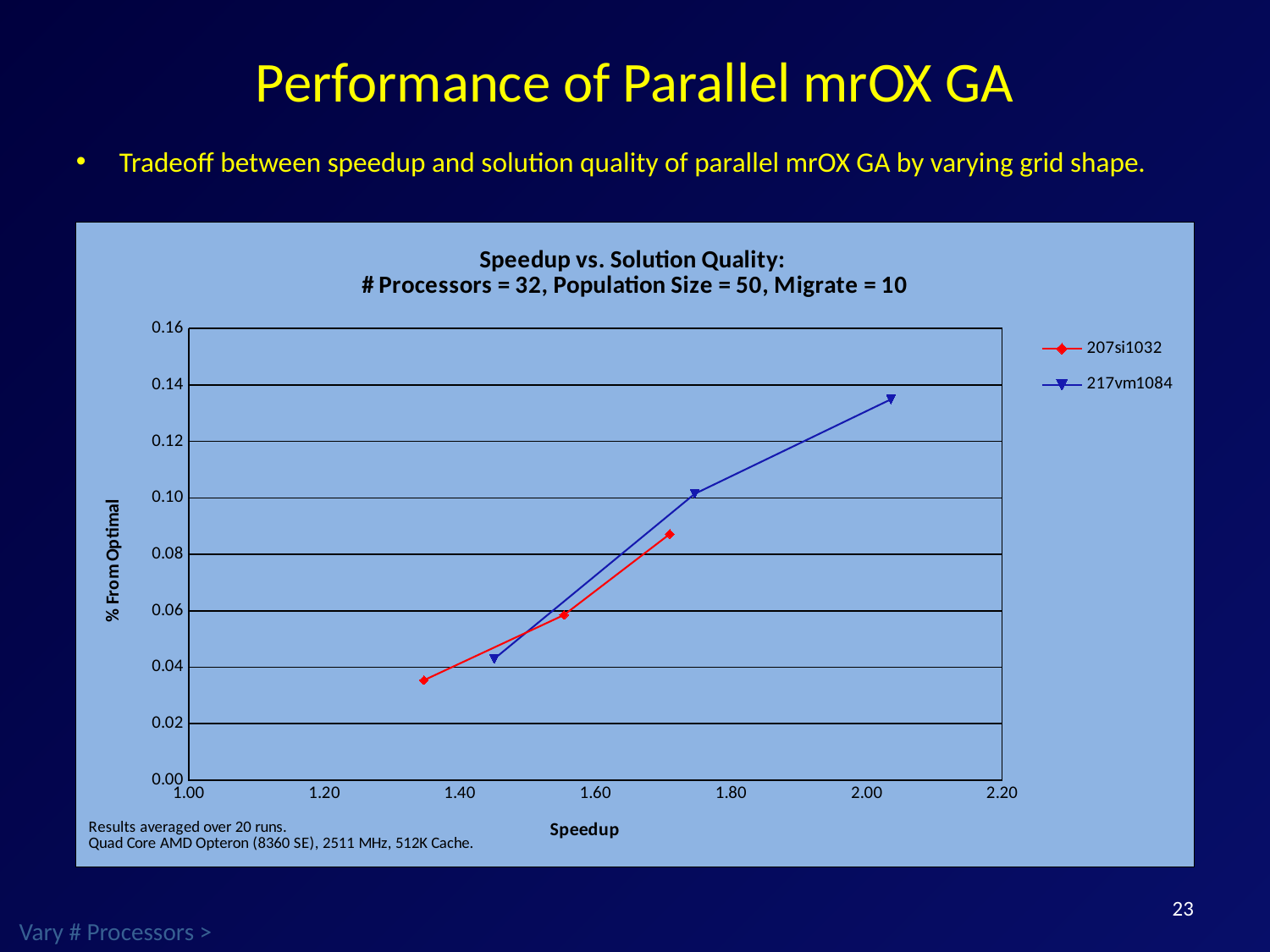
Which series reaches the higher maximum Speedup, 207si1032 or 217vm1084? 217vm1084 Is the lowest % From Optimal value for the 207si1032 series greater or less than 0.04? less How many series does the legend list? 2 Which series reaches the higher maximum % From Optimal, 207si1032 or 217vm1084? 217vm1084 What kind of chart is shown on the slide? line chart Is the highest % From Optimal value for the 207si1032 series greater or less than 0.10? less How many data points are plotted for the 217vm1084 series? 3 How many data points are plotted for the 207si1032 series? 3 Does % From Optimal rise or fall as Speedup increases for the 207si1032 series? rise Is the highest % From Optimal value for the 217vm1084 series greater or less than 0.12? greater Does % From Optimal rise or fall as Speedup increases for the 217vm1084 series? rise What is the label of the x axis? Speedup